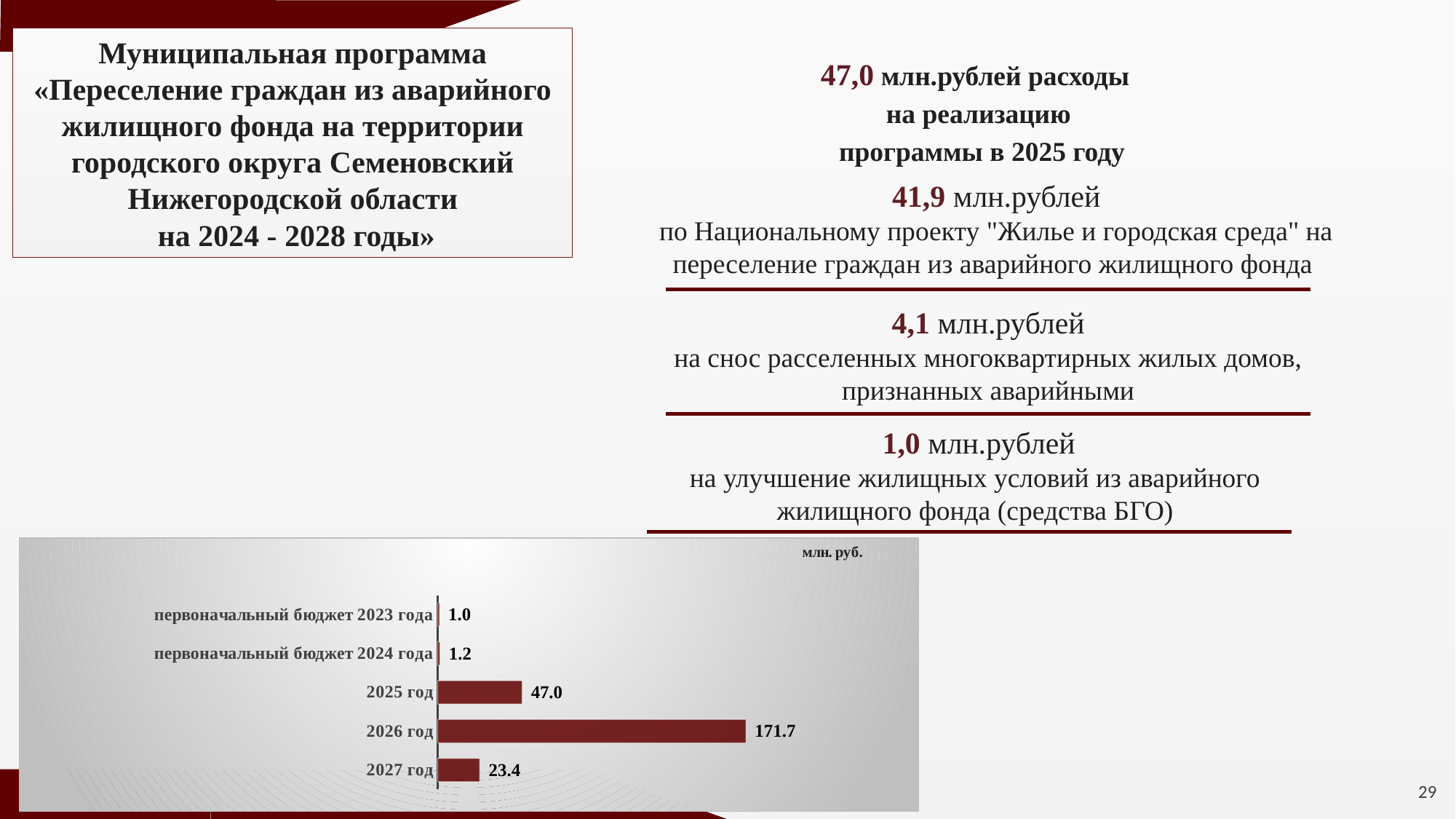
What is the value for 2026 год in the chart? 171.7 Which category has the lowest value in the chart? первоначальный бюджет 2023 года What is the value for 2025 год in the chart? 47.0 How many categories are shown in the chart? 5 Which category has the highest value in the chart? 2026 год What is the value for первоначальный бюджет 2024 года in the chart? 1.2 What unit label is shown in the top right corner of the chart? млн. руб. What is the value for 2027 год in the chart? 23.4 Which is larger, the value for 2027 год or the value for первоначальный бюджет 2024 года? 2027 год What kind of chart is shown on the slide? bar chart What is the difference between the values for 2026 год and 2025 год? 124.7 What is the difference between the values for 2025 год and 2027 год? 23.6